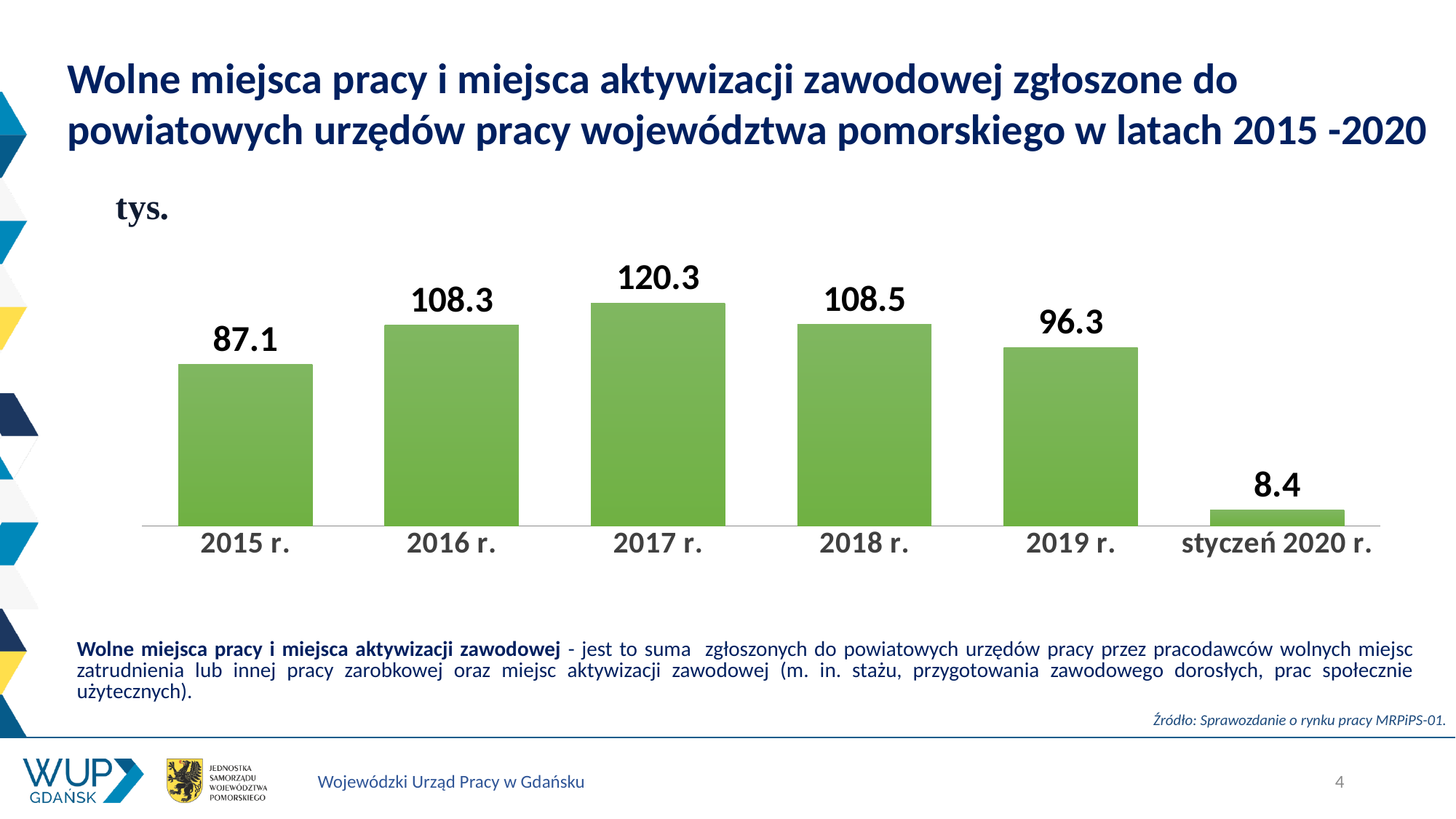
Which is larger, the value for 2016 r. or the value for 2019 r.? 2016 r. What kind of chart is shown on the slide? bar chart How many categories are shown on the x axis? 6 Which category has the lowest value? styczeń 2020 r. What is the value for 2017 r.? 120.3 What is the value for styczeń 2020 r.? 8.4 What is the value for 2019 r.? 96.3 What is the value for 2015 r.? 87.1 Which category has the highest value? 2017 r. What is the difference between the values for 2018 r. and 2019 r.? 12.2 What is the difference between the values for 2017 r. and 2015 r.? 33.2 What unit label is shown above the chart? tys.